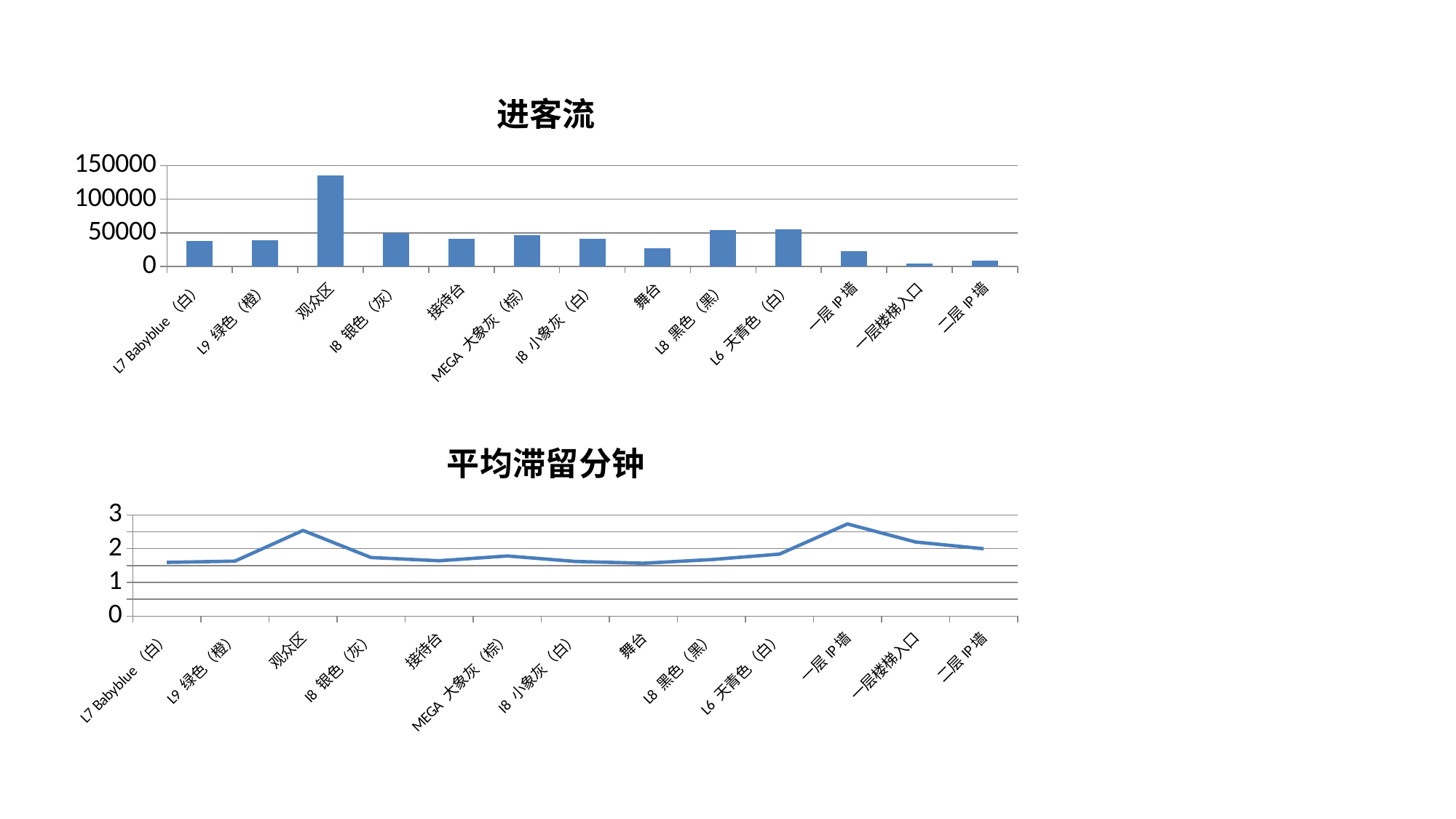
In the 平均滞留分钟 chart, is the value for 观众区 greater or less than 2? greater In the 进客流 chart, which category has the highest value? 观众区 How many categories are shown on the x axis of the 进客流 chart? 13 In the 进客流 chart, which is larger, the value for 观众区 or the value for 舞台? 观众区 In the 进客流 chart, is the value for 观众区 greater or less than 100000? greater In the 平均滞留分钟 chart, which category has the highest value? 一层 IP 墙 In the 平均滞留分钟 chart, which is larger, the value for 一层 IP 墙 or the value for 舞台? 一层 IP 墙 What kind of chart is the top chart titled 进客流? bar chart In the 进客流 chart, which category has the lowest value? 一层楼梯入口 In the 平均滞留分钟 chart, is the value for 接待台 greater or less than 2? less What kind of chart is the bottom chart titled 平均滞留分钟? line chart